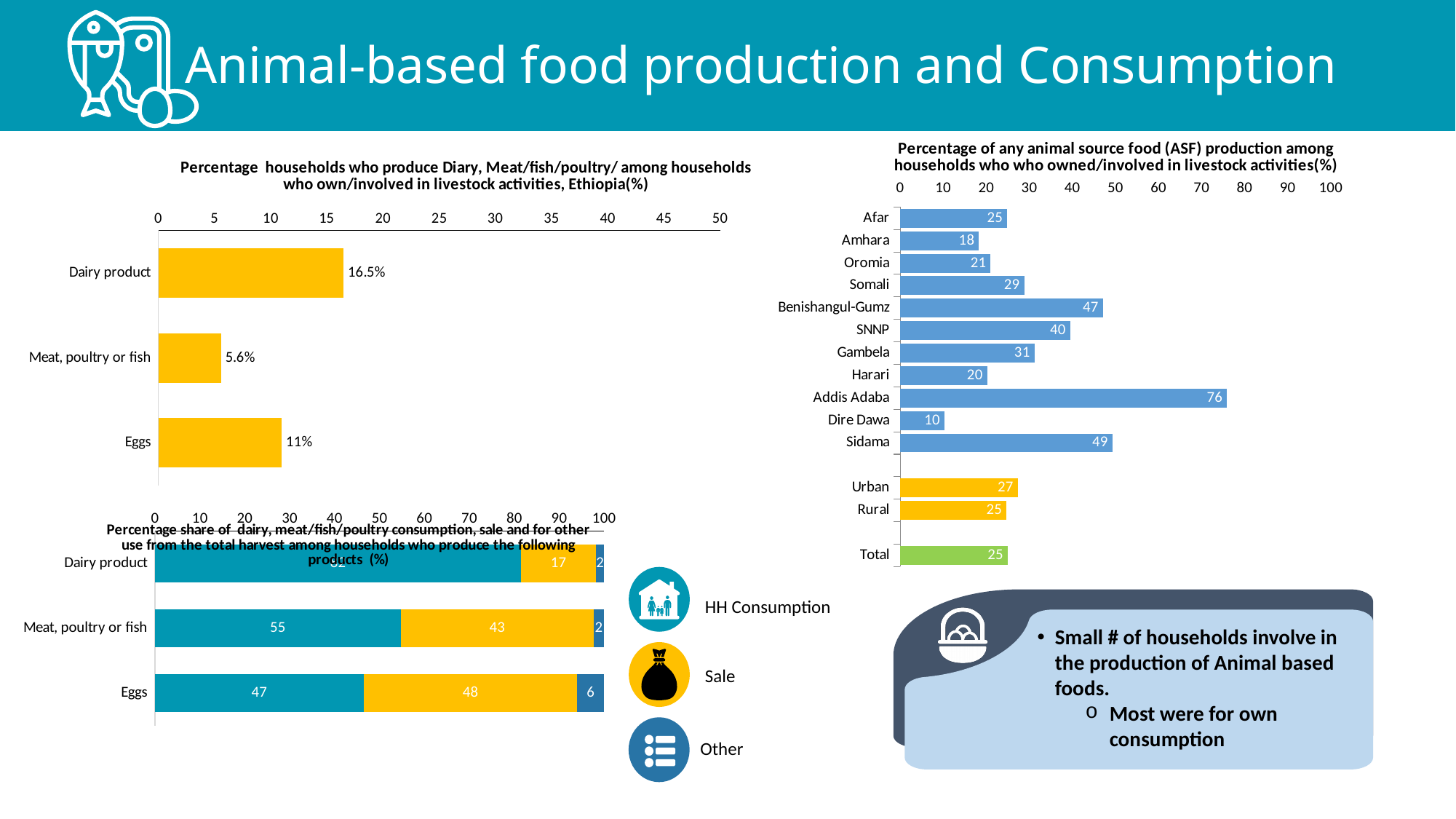
In the right-hand chart on ASF production by region, what is the value for Benishangul-Gumz? 47 In the top-left chart on households producing dairy, meat/fish/poultry, what is the difference between the Dairy product and Eggs values? 5.5% In the top-left chart on households producing dairy, meat/fish/poultry, which category has the lowest value? Meat, poultry or fish In the right-hand chart on ASF production by region, which region has the lowest value? Dire Dawa In the bottom-left stacked chart on share of consumption, sale and other use, what is the HH Consumption value for Meat, poultry or fish? 55 In the right-hand chart on ASF production by region, what is the value for Urban? 27 In the right-hand chart on ASF production by region, which region has the highest value? Addis Adaba In the bottom-left stacked chart on share of consumption, sale and other use, what is the Sale value for Eggs? 48 In the right-hand chart on ASF production by region, what is the difference between Addis Adaba and Amhara? 58 In the right-hand chart on ASF production by region, which is larger, Sidama or SNNP? Sidama How many series does the legend of the bottom-left stacked chart list? 3 In the top-left chart on households producing dairy, meat/fish/poultry, what is the value for Dairy product? 16.5%